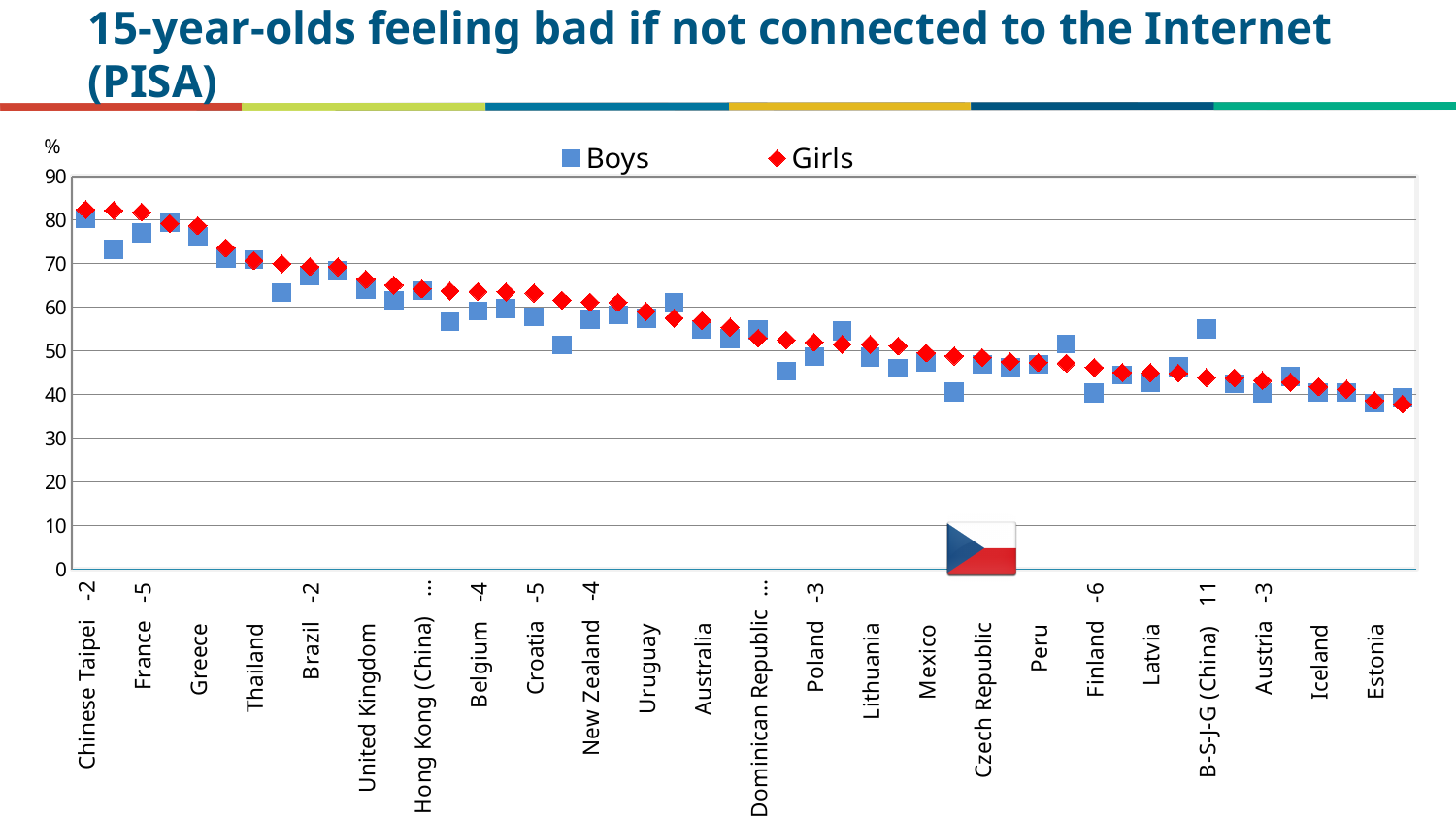
Is the Boys value for Finland greater or less than 50? less Do the Girls values generally rise or fall from left to right along the x axis? Fall Is the Girls value for Chinese Taipei greater or less than 80? greater Which has the higher Girls value, Chinese Taipei or Estonia? Chinese Taipei What is the title of the chart on the slide? 15-year-olds feeling bad if not connected to the Internet (PISA) Is the Girls value for Belgium greater or less than 60? greater How many series does the chart legend list? 2 What are the two series shown in the chart legend? Boys and Girls What kind of chart is shown on the slide? Scatter chart For B-S-J-G (China), which is larger, the Boys value or the Girls value? Boys For Finland, which is larger, the Boys value or the Girls value? Girls